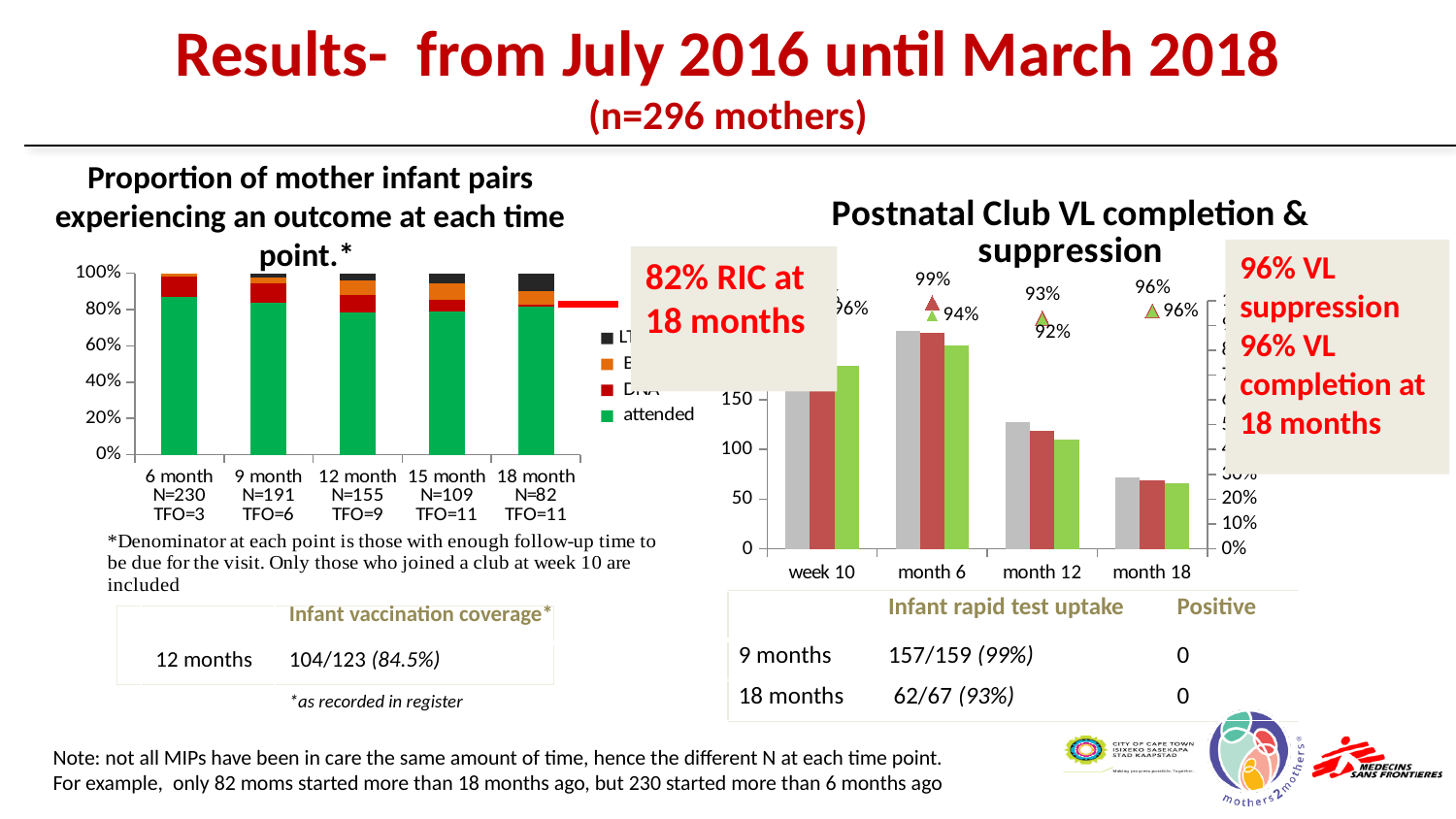
In the 'Postnatal Club VL completion & suppression' chart, what is the difference between the two percentage labels at month 6 (99% and 94%)? 5 percentage points In the left chart, what colour represents the 'attended' category? Green In the left chart, which time point has the highest 'attended' proportion? 6 month In the 'Postnatal Club VL completion & suppression' chart, what is the lower percentage label shown at month 12? 92% In the left chart, is the 'attended' proportion at 6 month greater or less than 80%? greater What kind of chart is the left chart titled 'Proportion of mother infant pairs experiencing an outcome at each time point'? Stacked bar chart In the 'Postnatal Club VL completion & suppression' chart, how many bars are plotted for each time point? 3 In the 'Postnatal Club VL completion & suppression' chart, do the bar heights rise or fall from month 6 to month 18? fall In the 'Postnatal Club VL completion & suppression' chart, which time point has the tallest bars? month 6 In the left chart, how many time points are shown on the x axis? 5 In the 'Postnatal Club VL completion & suppression' chart, how many time points are shown on the x axis? 4 In the 'Postnatal Club VL completion & suppression' chart, what is the highest percentage label shown at month 6? 99%